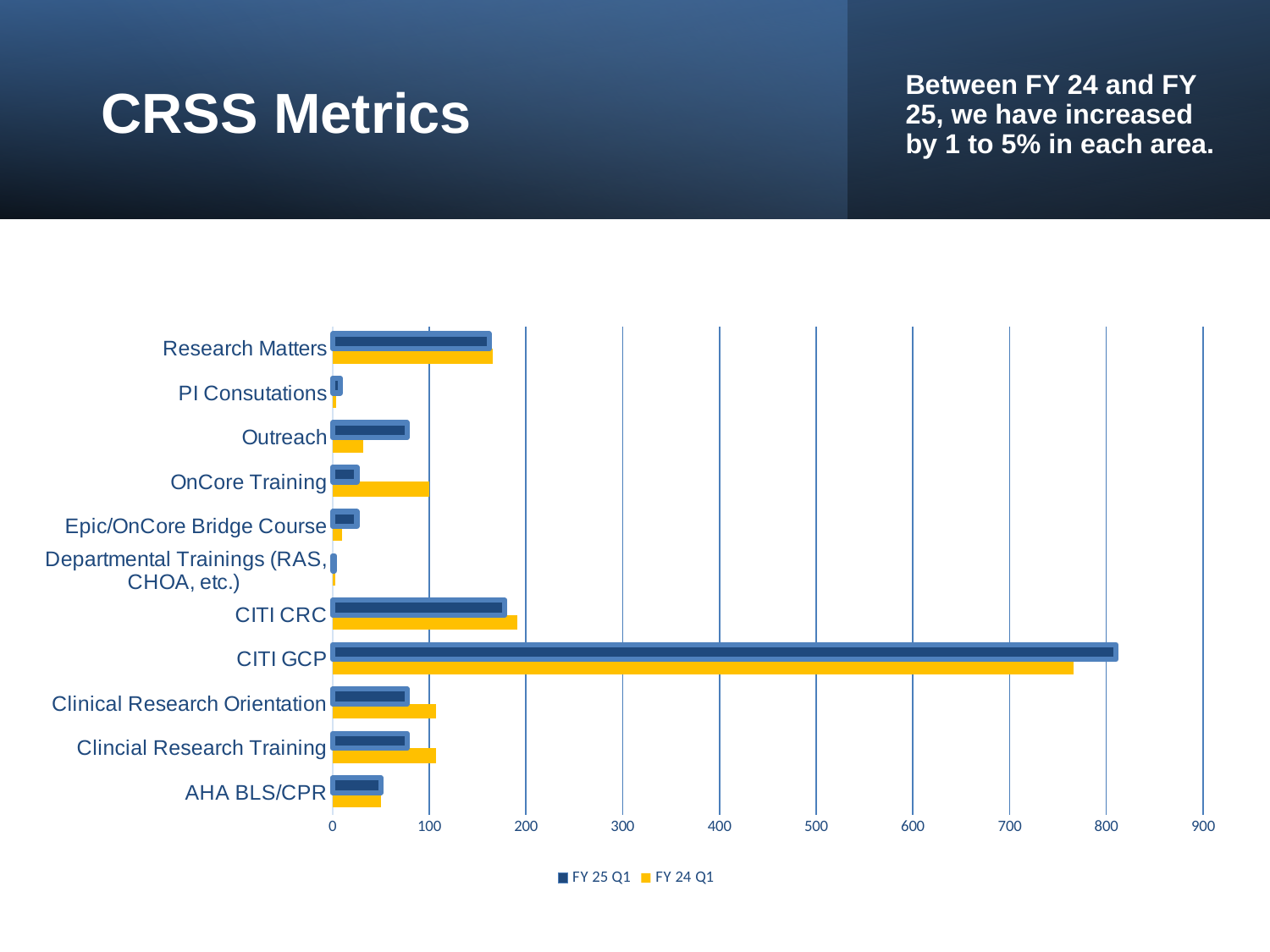
Which category has the highest FY 24 Q1 value? CITI GCP Which category has the highest FY 25 Q1 value? CITI GCP Is the FY 25 Q1 value for Research Matters greater or less than 100? greater Is the FY 25 Q1 value for OnCore Training greater or less than 100? less Which colour represents the FY 24 Q1 series in the legend? yellow How many categories are plotted on the chart? 11 Is the FY 25 Q1 value for CITI GCP greater or less than 700? greater For OnCore Training, which series has the larger value, FY 25 Q1 or FY 24 Q1? FY 24 Q1 What kind of chart is shown on the slide? bar chart How many series does the legend list? 2 For Outreach, which series has the larger value, FY 25 Q1 or FY 24 Q1? FY 25 Q1